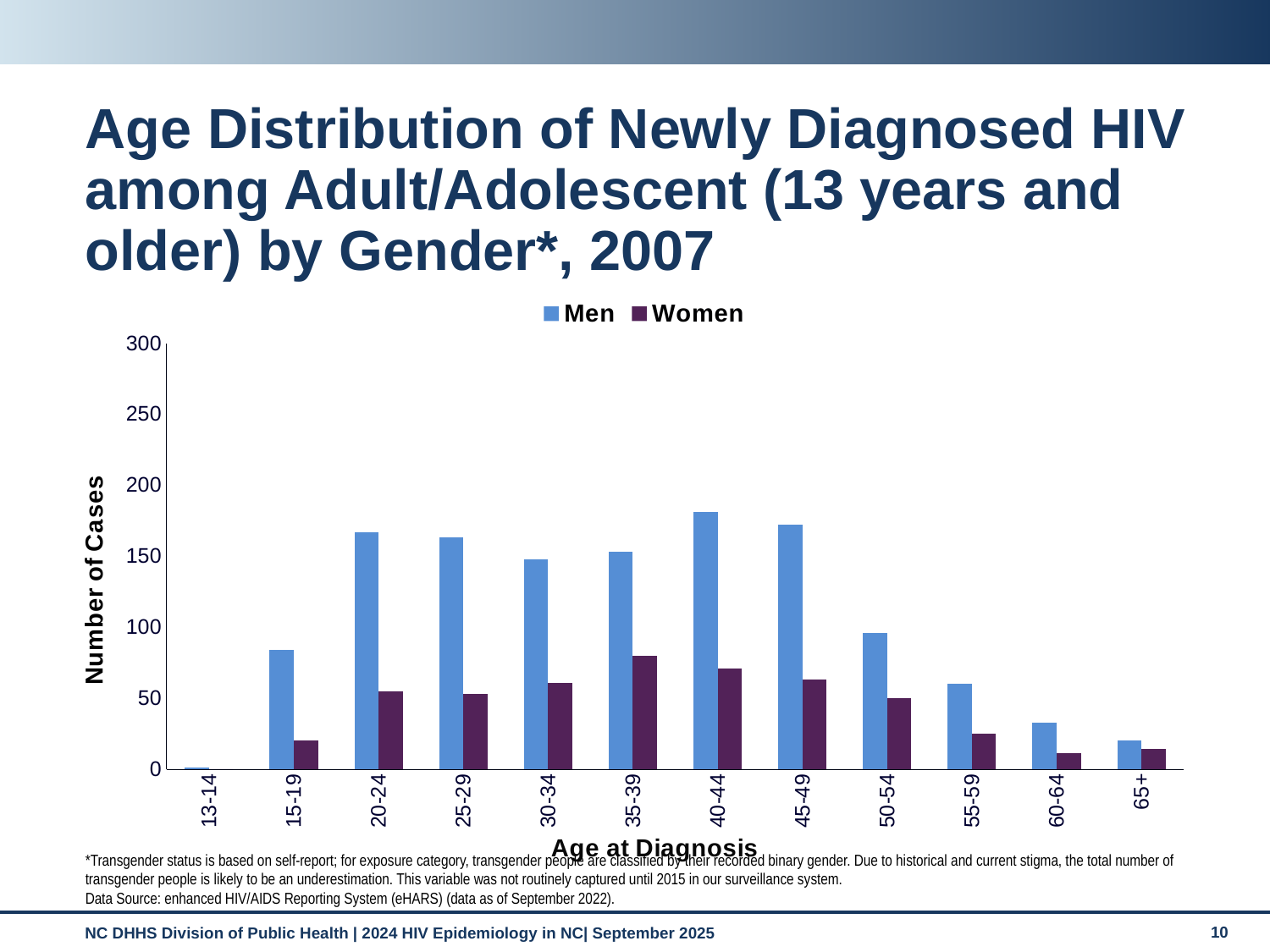
What kind of chart is shown on the slide? Bar chart Is the value for Men in the 40-44 age group greater or less than 150? greater Which age group has the highest number of cases for Men? 40-44 Is the value for Women in the 35-39 age group greater or less than 50? greater Which age group has the lowest number of cases for Men? 13-14 Is the value for Men in the 60-64 age group greater or less than 50? less In the 40-44 age group, which series has more cases, Men or Women? Men Do the values for Men rise or fall from the 45-49 age group to the 65+ age group? Fall How many age groups are shown on the x axis? 12 How many series does the legend list? 2 Which age group has the highest number of cases for Women? 35-39